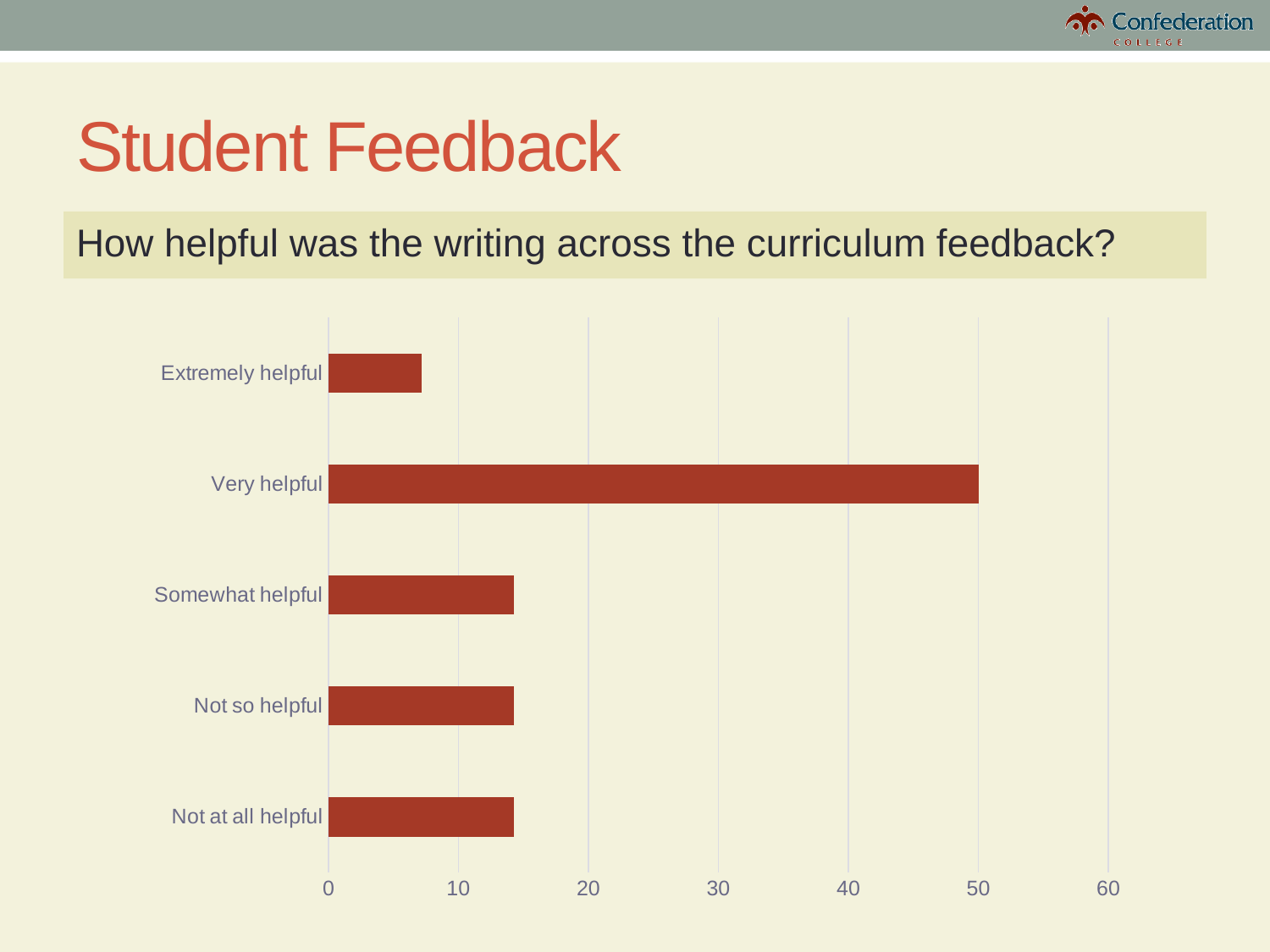
Which category has the lowest value? Extremely helpful Is the value for Not at all helpful greater or less than 10? greater What question does the chart on the slide present responses to? How helpful was the writing across the curriculum feedback? How many categories are shown in the chart? 5 What kind of chart is shown on the slide? bar chart Is the value for Somewhat helpful greater or less than 10? greater Which category has the highest value? Very helpful Which is larger, the value for Extremely helpful or the value for Not at all helpful? Not at all helpful Which is larger, the value for Very helpful or the value for Somewhat helpful? Very helpful Is the value for Extremely helpful greater or less than 10? less What is the value for Very helpful? 50